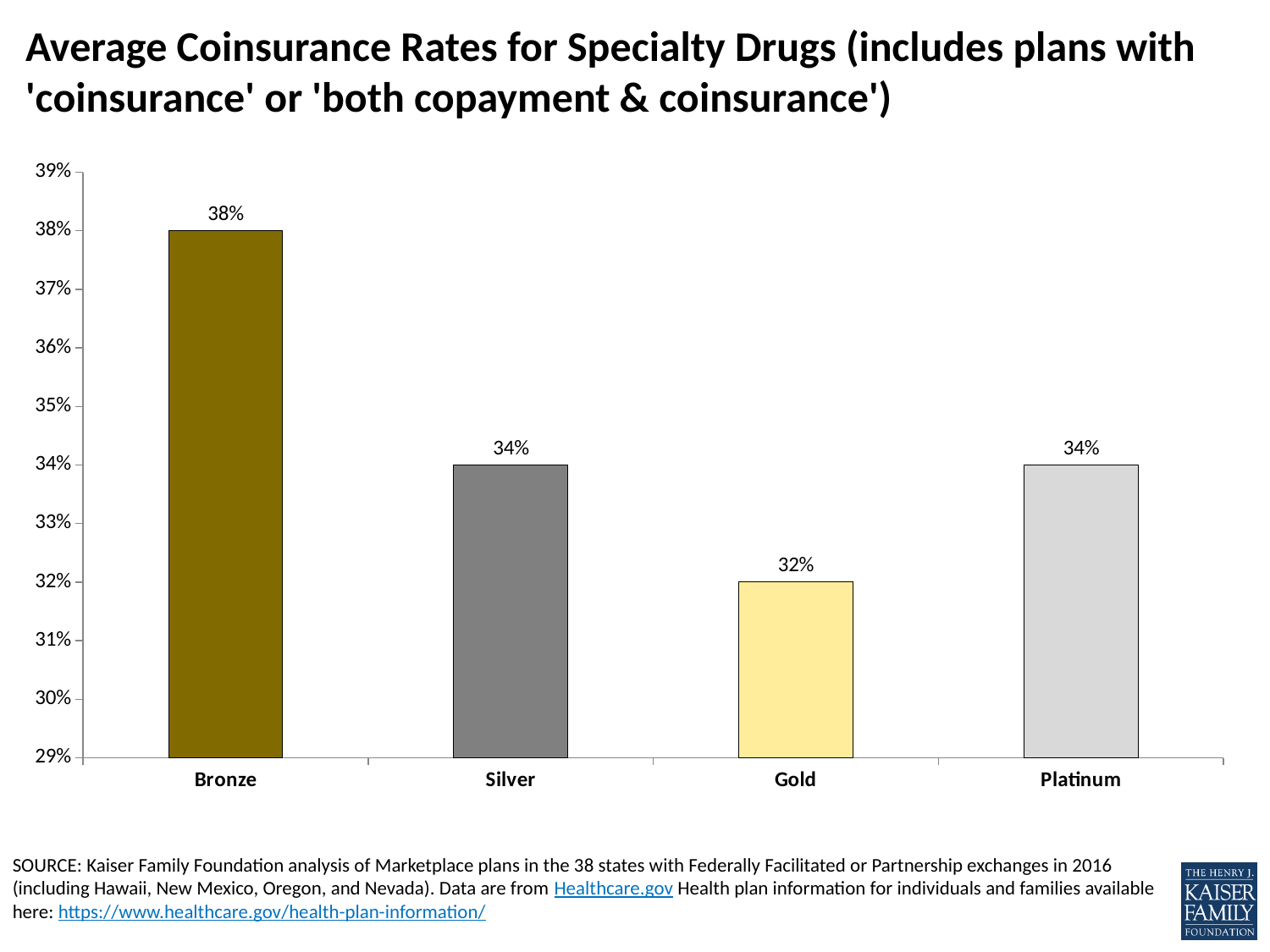
What is the difference between the average coinsurance rates for Silver and Gold plans? 2% What is the average coinsurance rate for specialty drugs for Gold plans? 32% How many plan tiers are shown on the chart? 4 What is the average coinsurance rate for specialty drugs for Platinum plans? 34% Which has a higher average coinsurance rate for specialty drugs, Bronze or Silver? Bronze Is the average coinsurance rate for Gold plans greater or less than 35%? less Which plan tier has the highest average coinsurance rate for specialty drugs? Bronze What is the value at the top of the vertical axis? 39% What is the difference between the average coinsurance rates for Bronze and Gold plans? 6% Which plan tier has the lowest average coinsurance rate for specialty drugs? Gold What is the average coinsurance rate for specialty drugs for Bronze plans? 38% What kind of chart is shown on the slide? Bar chart